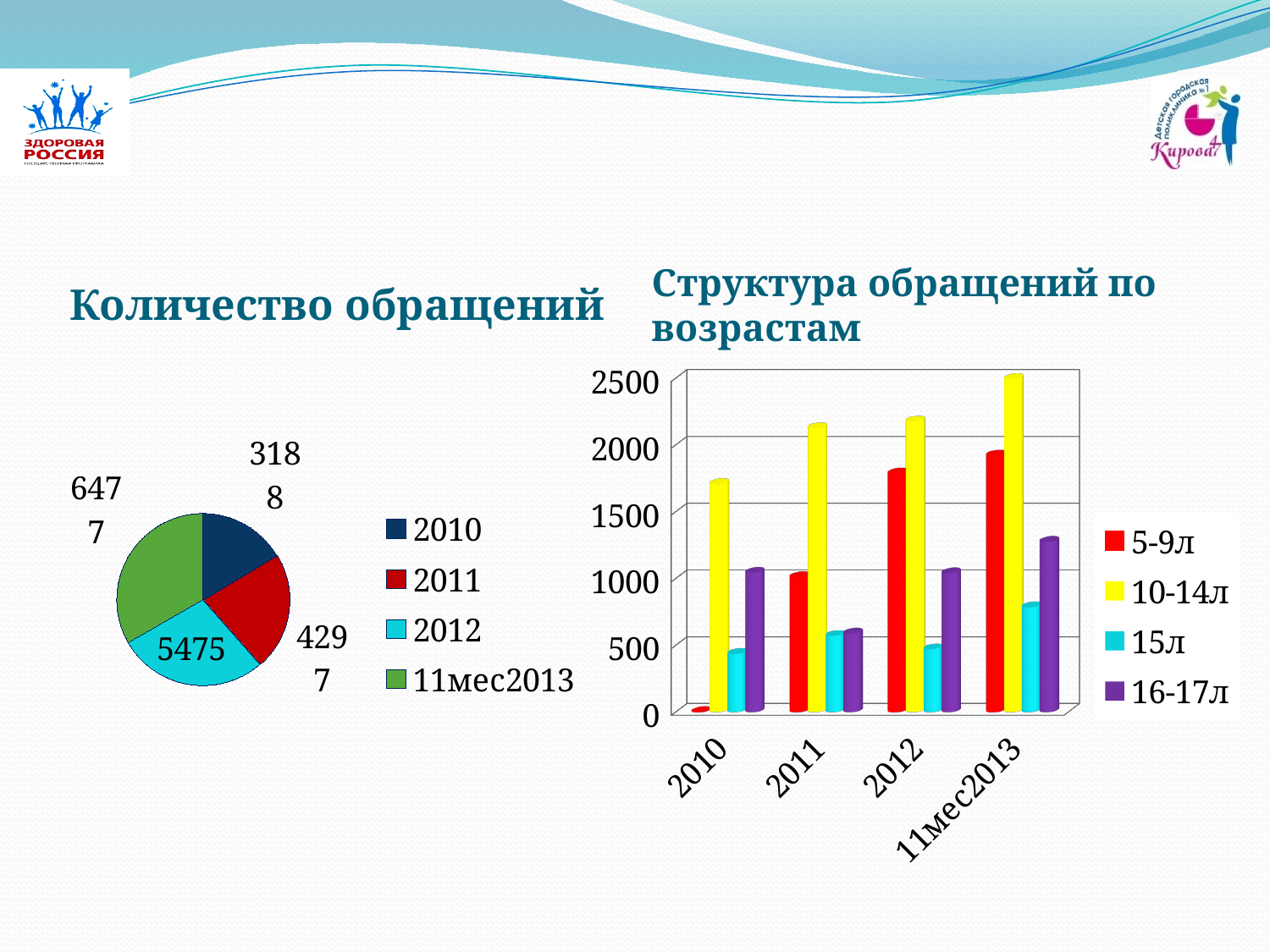
In the chart 'Структура обращений по возрастам', does the value for 10-14л rise or fall from 2010 to 11мес2013? rise In the pie chart 'Количество обращений', which category has the largest value? 11мес2013 In the pie chart 'Количество обращений', which category has the smallest value? 2010 What kind of chart is 'Количество обращений'? pie chart What kind of chart is 'Структура обращений по возрастам'? bar chart How many series does the legend of the chart 'Структура обращений по возрастам' list? 4 In the chart 'Структура обращений по возрастам', is the value for 16-17л in 2011 greater or less than 1000? less In the pie chart 'Количество обращений', what is the value for 2012? 5475 In the chart 'Структура обращений по возрастам', is the value for 10-14л in 11мес2013 greater or less than 2000? greater In the pie chart 'Количество обращений', what is the value for 2010? 3188 In the pie chart 'Количество обращений', what is the difference between the values for 2012 and 2011? 1178 How many slices does the pie chart 'Количество обращений' have? 4